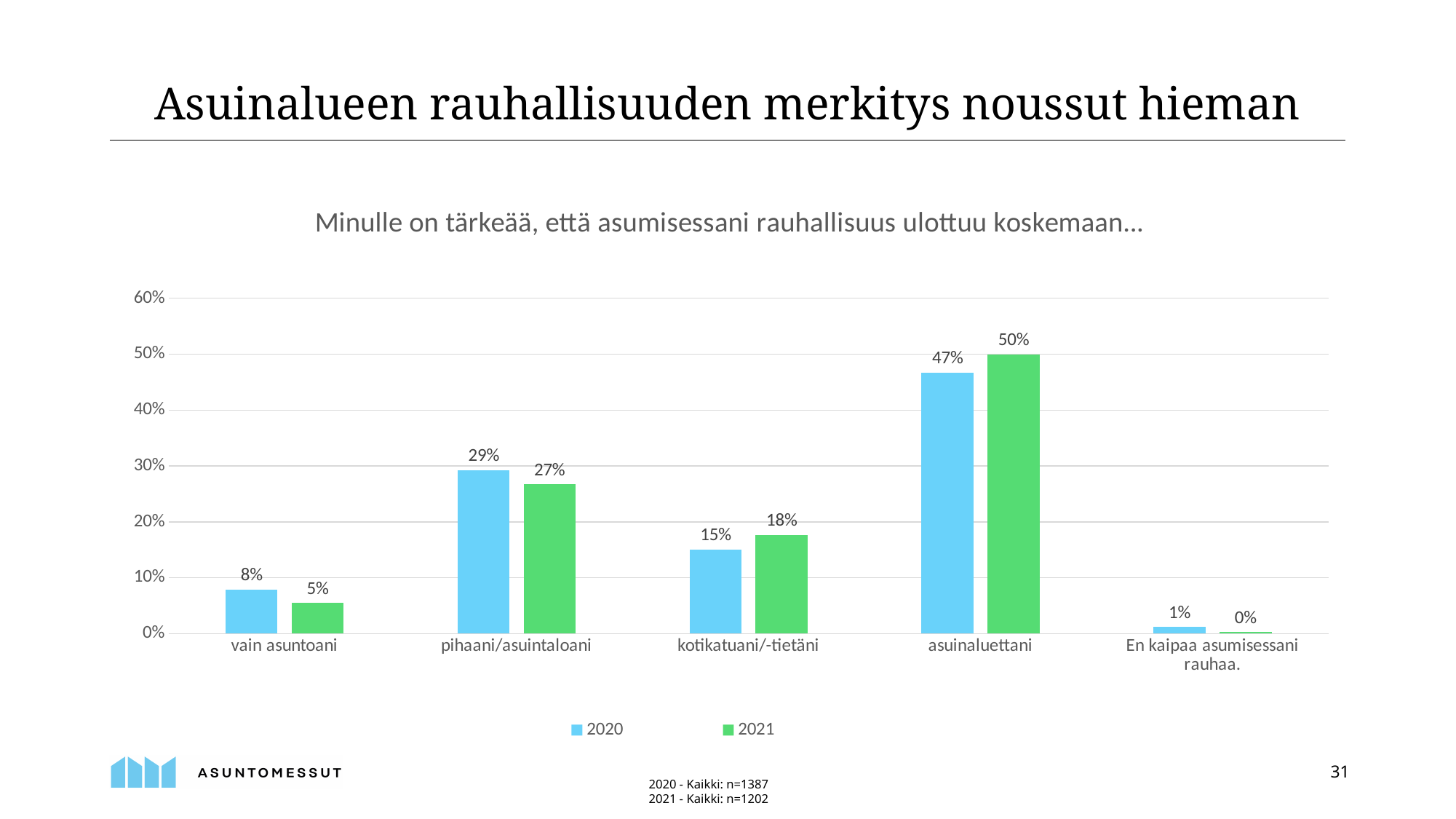
What is the 2021 value for asuinaluettani? 50% Which category has the highest 2020 value? asuinaluettani What is the 2021 value for kotikatuani/-tietäni? 18% How many series does the legend list? 2 What is the title of the chart? Minulle on tärkeää, että asumisessani rauhallisuus ulottuu koskemaan… What is the 2020 value for pihaani/asuintaloani? 29% What is the 2020 value for vain asuntoani? 8% Which category has the lowest 2021 value? En kaipaa asumisessani rauhaa. For pihaani/asuintaloani, which year has the larger value, 2020 or 2021? 2020 What kind of chart is shown on the slide? bar chart How many categories are shown on the x axis? 5 What is the difference between the 2021 and 2020 values for asuinaluettani? 3%